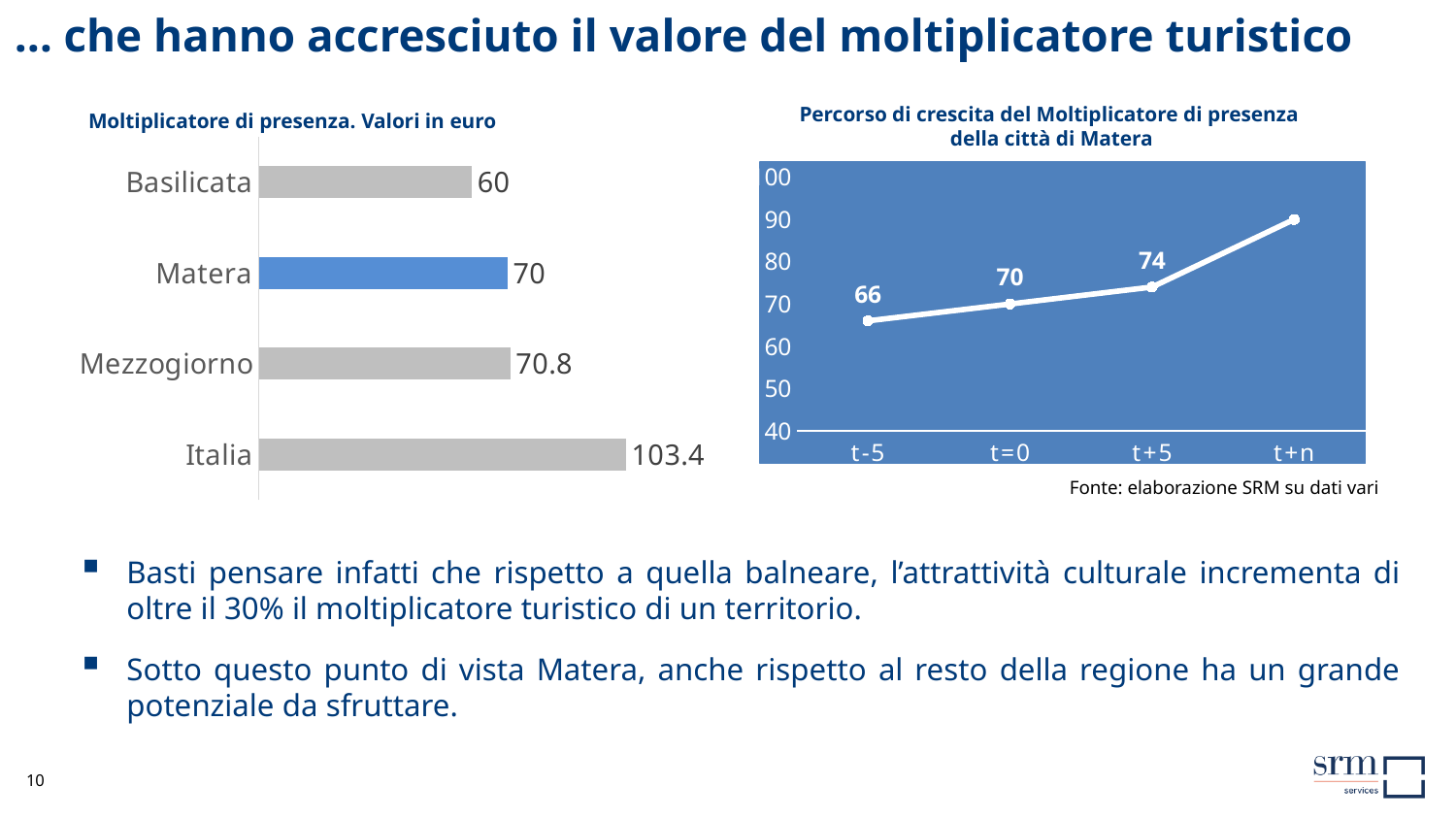
What kind of chart is the one on the left titled 'Moltiplicatore di presenza. Valori in euro'? Bar chart In the line chart 'Percorso di crescita del Moltiplicatore di presenza della città di Matera', what is the value at t=0? 70 In the line chart 'Percorso di crescita del Moltiplicatore di presenza della città di Matera', is the value at t+n greater or less than 80? greater In the bar chart 'Moltiplicatore di presenza. Valori in euro', which category has the highest value? Italia In the bar chart 'Moltiplicatore di presenza. Valori in euro', what is the difference between the values for Italia and Matera? 33.4 In the bar chart 'Moltiplicatore di presenza. Valori in euro', what is the value for Italia? 103.4 In the bar chart 'Moltiplicatore di presenza. Valori in euro', what is the value for Basilicata? 60 In the bar chart 'Moltiplicatore di presenza. Valori in euro', which category has the lowest value? Basilicata In the bar chart 'Moltiplicatore di presenza. Valori in euro', how many categories are shown? 4 In the bar chart 'Moltiplicatore di presenza. Valori in euro', which bar is highlighted in blue rather than grey? Matera In the line chart 'Percorso di crescita del Moltiplicatore di presenza della città di Matera', what is the value at t+5? 74 In the line chart 'Percorso di crescita del Moltiplicatore di presenza della città di Matera', do the values rise or fall from t-5 to t+n? Rise